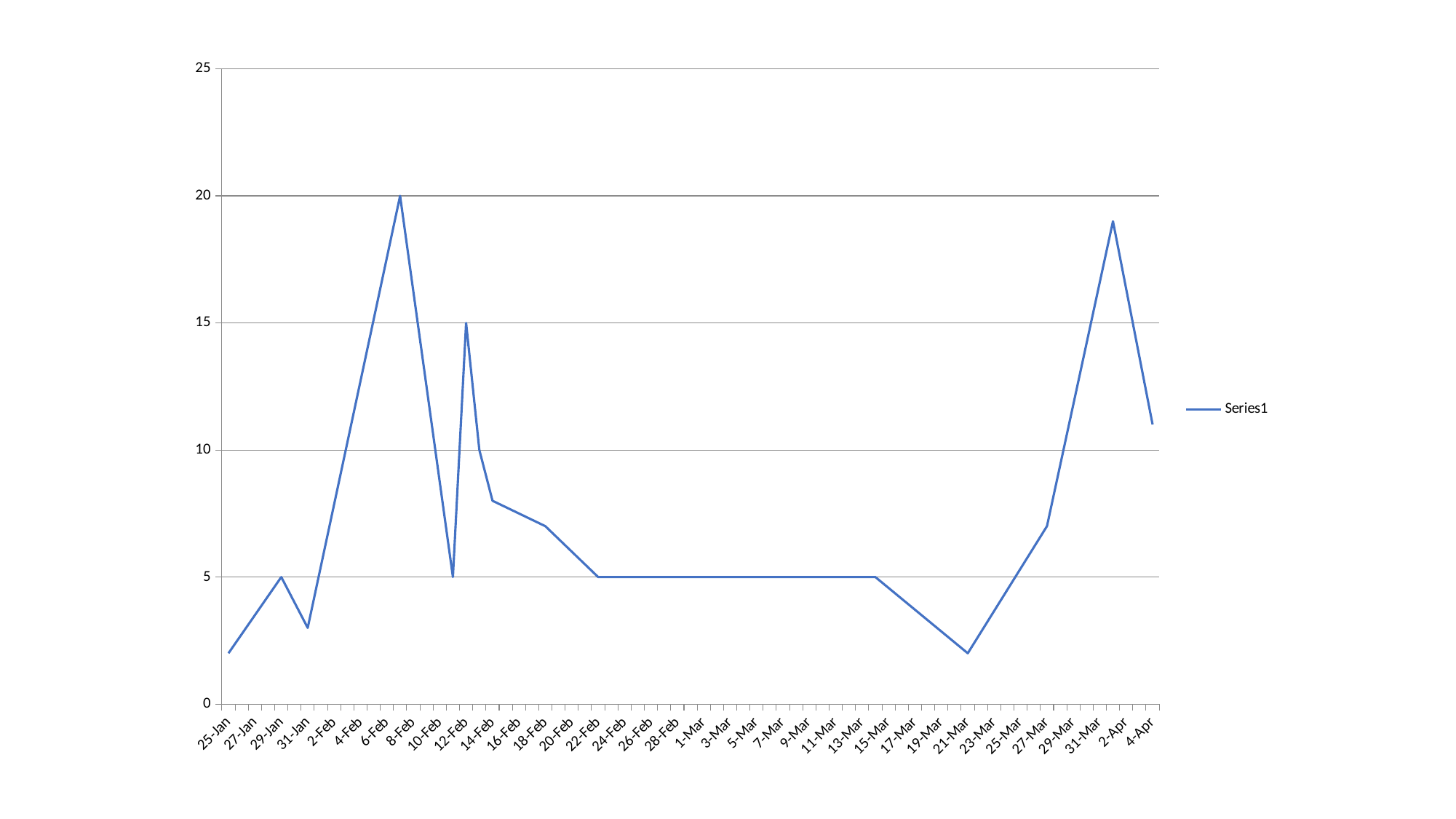
What is the name of the series shown in the legend? Series1 How many series does the legend list? 1 Is the value for 4-Apr greater or less than 10? greater Is the value for 25-Jan greater or less than 5? less What is the value for 29-Jan? 5 What is the value for 12-Feb? 15 What kind of chart is shown on the slide? line chart Is the value for 21-Mar greater or less than 5? less